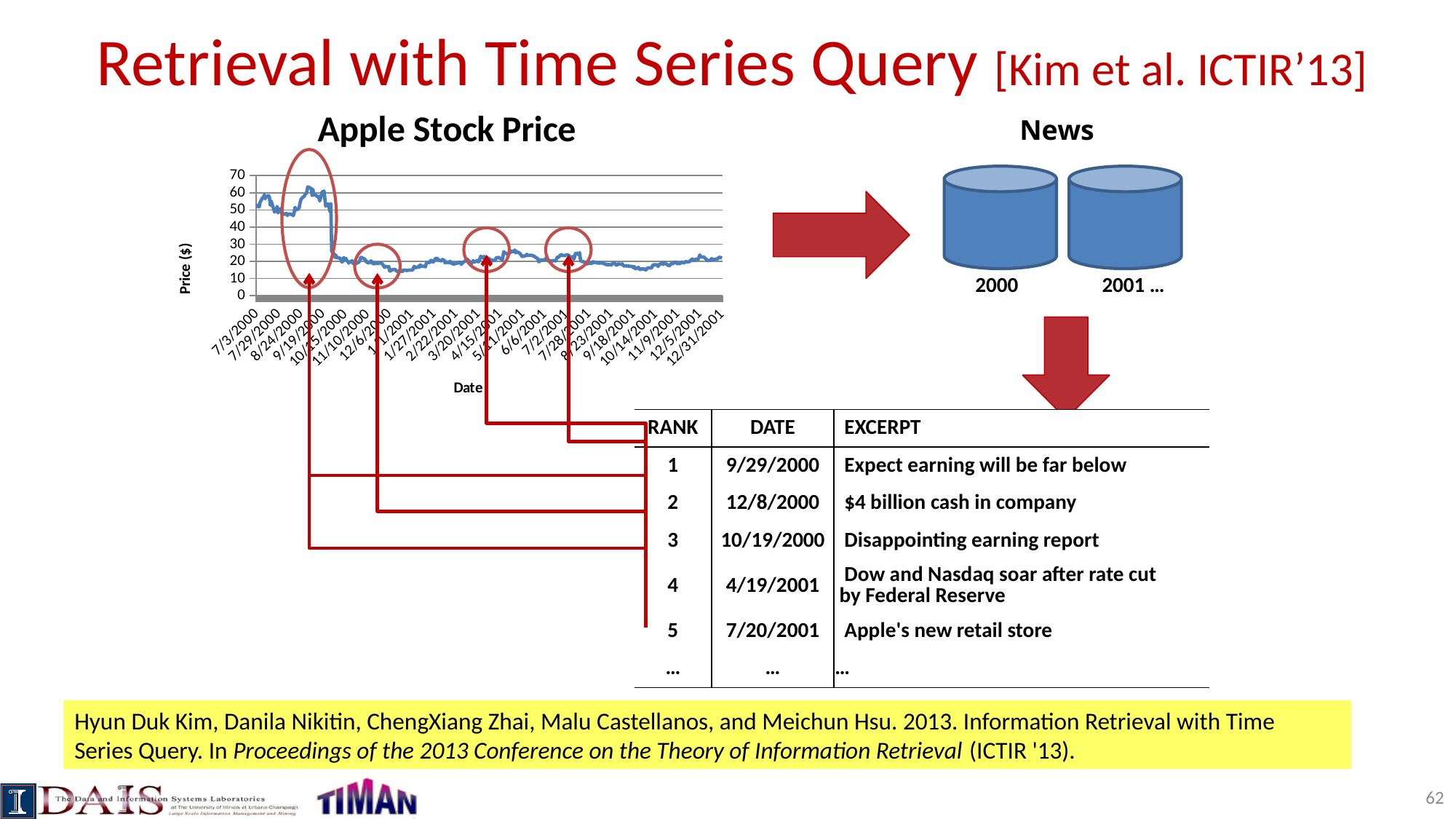
What is the highest tick value shown on the vertical axis of the Apple Stock Price chart? 70 In the Apple Stock Price chart, do the values overall rise or fall from 7/3/2000 to 12/31/2001? fall What is the title of the chart on the left of the slide? Apple Stock Price In the Apple Stock Price chart, is the value at 12/31/2001 greater or less than 40? less In the Apple Stock Price chart, is the value at 8/24/2000 greater or less than 40? greater In the Apple Stock Price chart, which is larger: the value at 7/3/2000 or the value at 12/31/2001? 7/3/2000 How many data series (lines) are plotted in the Apple Stock Price chart? 1 In the Apple Stock Price chart, is the value at 7/3/2000 greater or less than 40? greater What is the label on the vertical axis of the Apple Stock Price chart? Price ($) What kind of chart is the Apple Stock Price chart? line chart